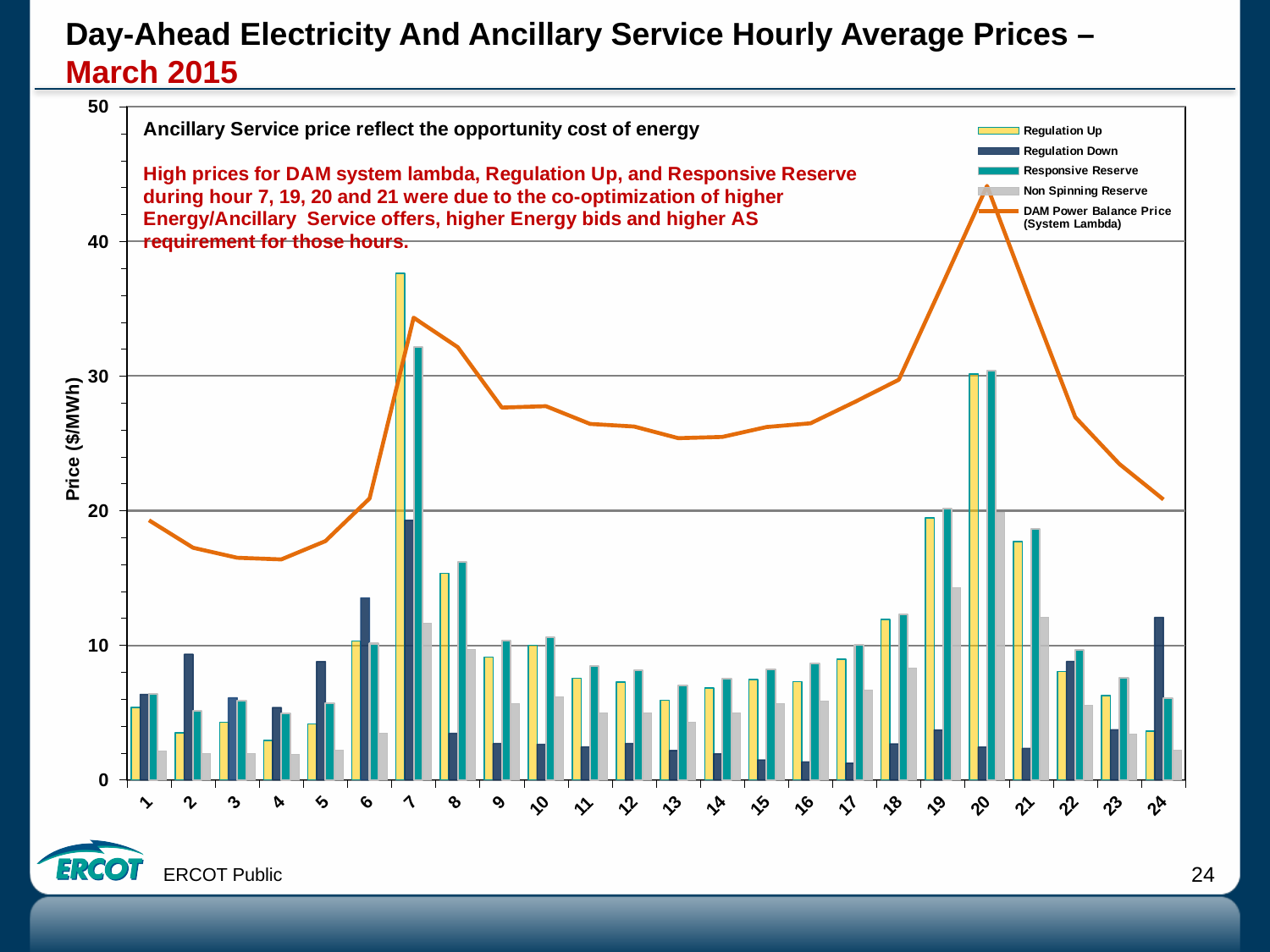
Is the Responsive Reserve value for hour 13 greater or less than 10? less What is the label on the y axis? Price ($/MWh) Is the DAM Power Balance Price for hour 20 greater or less than 40? greater In which hour is the Regulation Up price highest? 7 In which hour does the DAM Power Balance Price (System Lambda) line reach its peak? 20 Is the Regulation Up value for hour 7 greater or less than 30? greater How many series does the legend list? 5 Does the DAM Power Balance Price line rise or fall from hour 20 to hour 24? Fall What kind of chart is this? Combined bar and line chart In which hour is the Responsive Reserve price highest? 7 Which is larger, the Responsive Reserve value for hour 8 or for hour 9? Hour 8 How many hours are shown along the x axis? 24